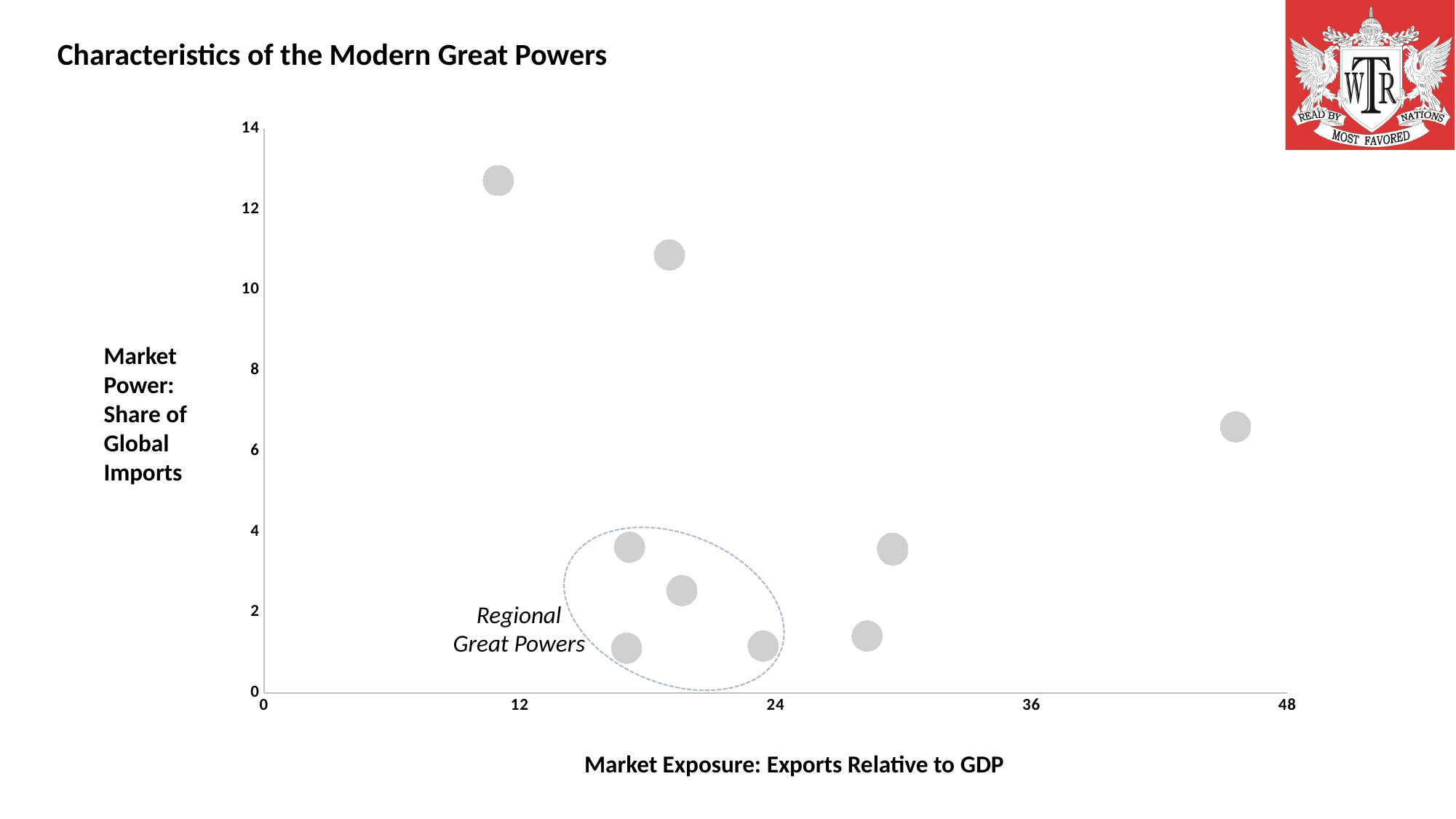
What kind of chart is shown on the slide? Scatter chart Is the exports-relative-to-GDP value for the highest point greater or less than 12? less Is the exports-relative-to-GDP value for the rightmost point greater or less than 36? greater What is the maximum value shown on the horizontal axis? 48 How many data points are enclosed by the dashed ellipse labelled "Regional Great Powers"? 4 What is the title of the chart? Characteristics of the Modern Great Powers Is the share of global imports for the highest point on the chart greater or less than 12? greater What is the label of the horizontal axis? Market Exposure: Exports Relative to GDP What is the maximum value shown on the vertical axis? 14